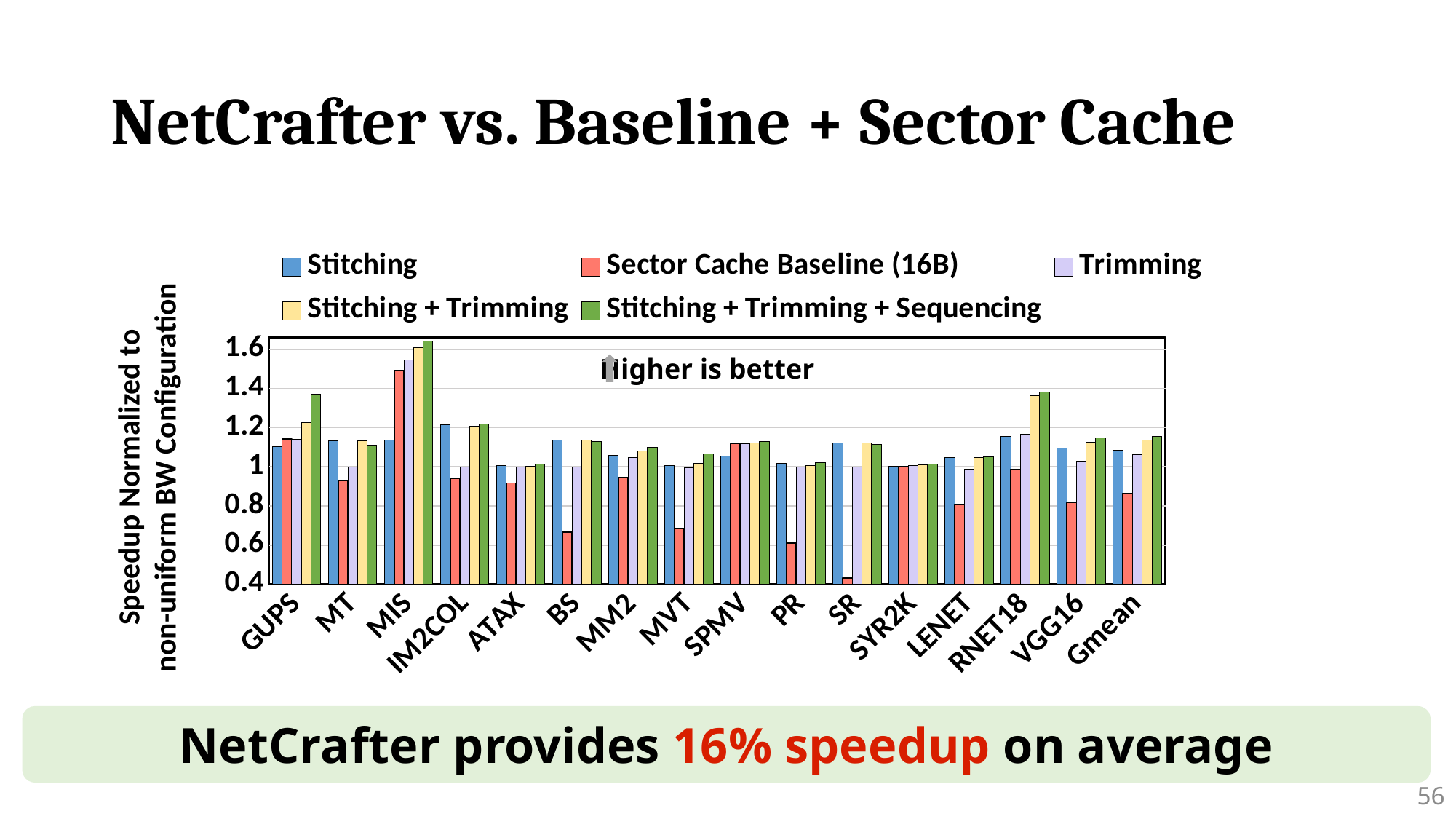
What kind of chart is shown on the slide? bar chart Is the Stitching + Trimming + Sequencing value for MIS greater or less than 1.4? greater Is the Stitching + Trimming + Sequencing value for GUPS greater or less than 1.2? greater Which category has the lowest value for the Sector Cache Baseline (16B) series? SR For BS, which is larger: the Stitching value or the Sector Cache Baseline (16B) value? Stitching Is the Sector Cache Baseline (16B) value for PR greater or less than 0.8? less What is the title of the y axis? Speedup Normalized to non-uniform BW Configuration For MIS, which is larger: the Stitching value or the Sector Cache Baseline (16B) value? Sector Cache Baseline (16B) How many series does the legend list? 5 How many categories are shown along the x axis? 16 Which category has the highest value for the Stitching + Trimming + Sequencing series? MIS